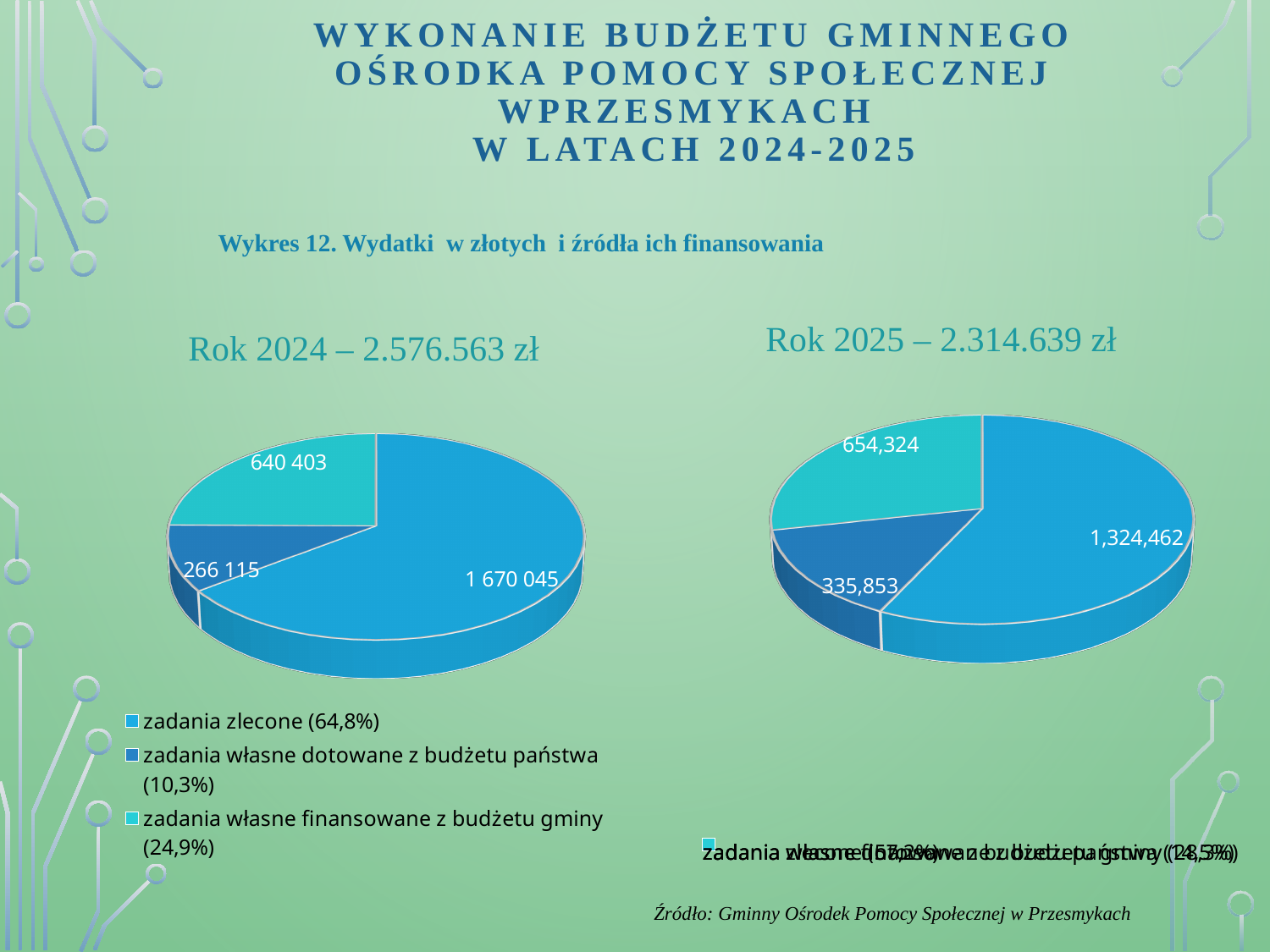
In the Rok 2024 chart, what is the value for zadania zlecone? 1 670 045 In the Rok 2024 chart, what is the value for zadania własne dotowane z budżetu państwa? 266 115 In the Rok 2024 chart, what is the value for zadania własne finansowane z budżetu gminy? 640 403 How many slices does the Rok 2025 pie chart have? 3 In the Rok 2024 chart, what share of the pie is zadania własne dotowane z budżetu państwa? 10,3% In the Rok 2024 chart, what share of the pie is zadania zlecone? 64,8% In the Rok 2024 chart, what is the difference between the largest slice (1 670 045) and the smallest slice (266 115)? 1 403 930 In the Rok 2025 chart, what is the value of the largest slice? 1,324,462 In the Rok 2025 chart, what is the value of the smallest slice? 335,853 What kind of chart is used for Rok 2024? pie chart What total amount is given in the title of the Rok 2025 chart? 2.314.639 zł In the Rok 2025 chart, what is the difference between the slices labelled 654,324 and 335,853? 318,471